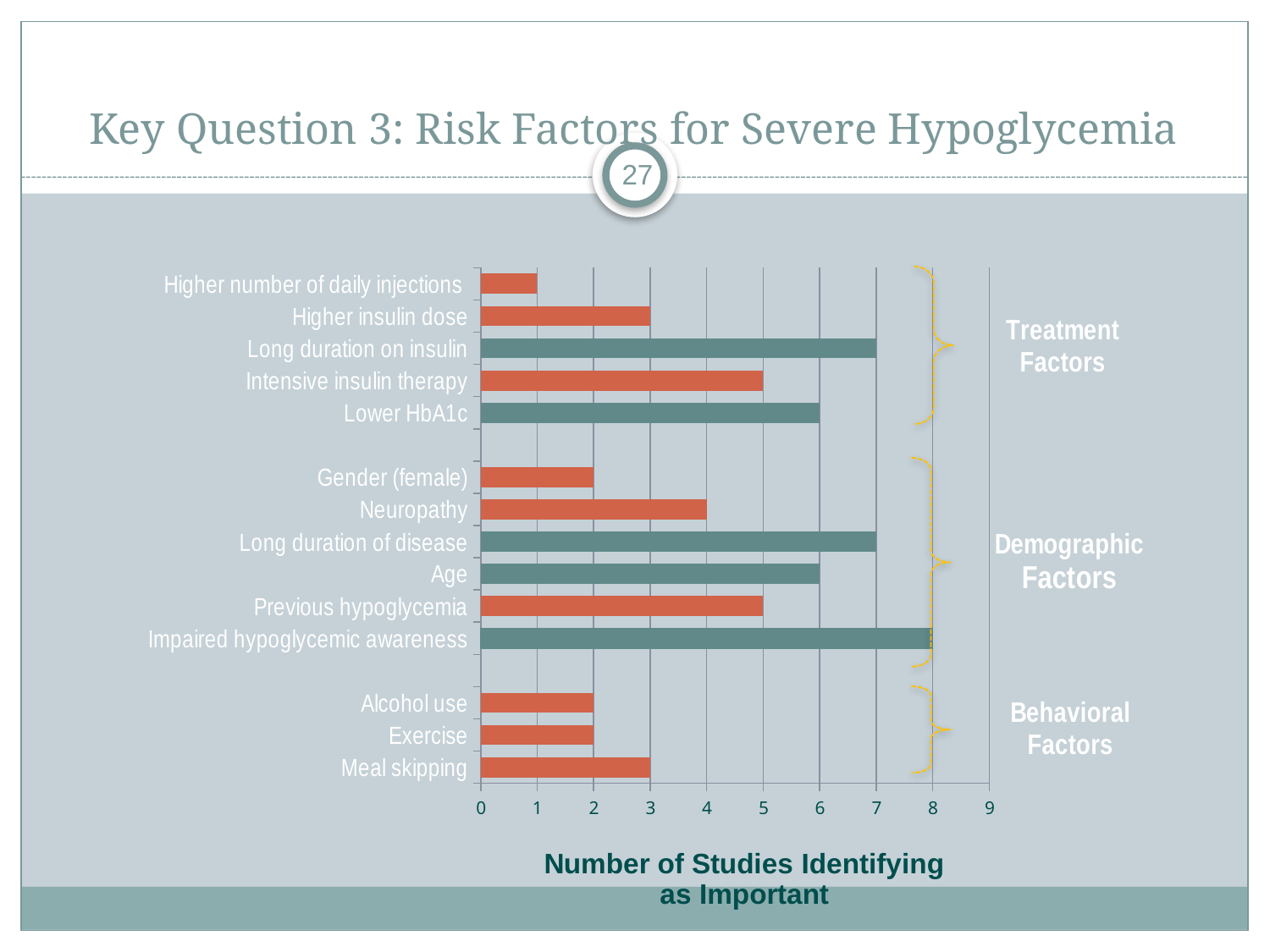
What is the label of the horizontal axis? Number of Studies Identifying as Important Which risk factor was identified as important by the most studies? Impaired hypoglycemic awareness What is the difference in the number of studies between Lower HbA1c and Higher insulin dose? 3 How many studies identified Impaired hypoglycemic awareness as important? 8 How many studies identified Meal skipping as important? 3 How many studies identified Neuropathy as important? 4 Into how many factor groups are the risk factors bracketed on the right of the chart? 3 Which risk factor was identified as important by the fewest studies? Higher number of daily injections What type of chart is shown on the slide? bar chart Which was identified by more studies, Intensive insulin therapy or Gender (female)? Intensive insulin therapy How many risk factors are plotted in the chart? 14 How many studies identified Long duration on insulin as important? 7